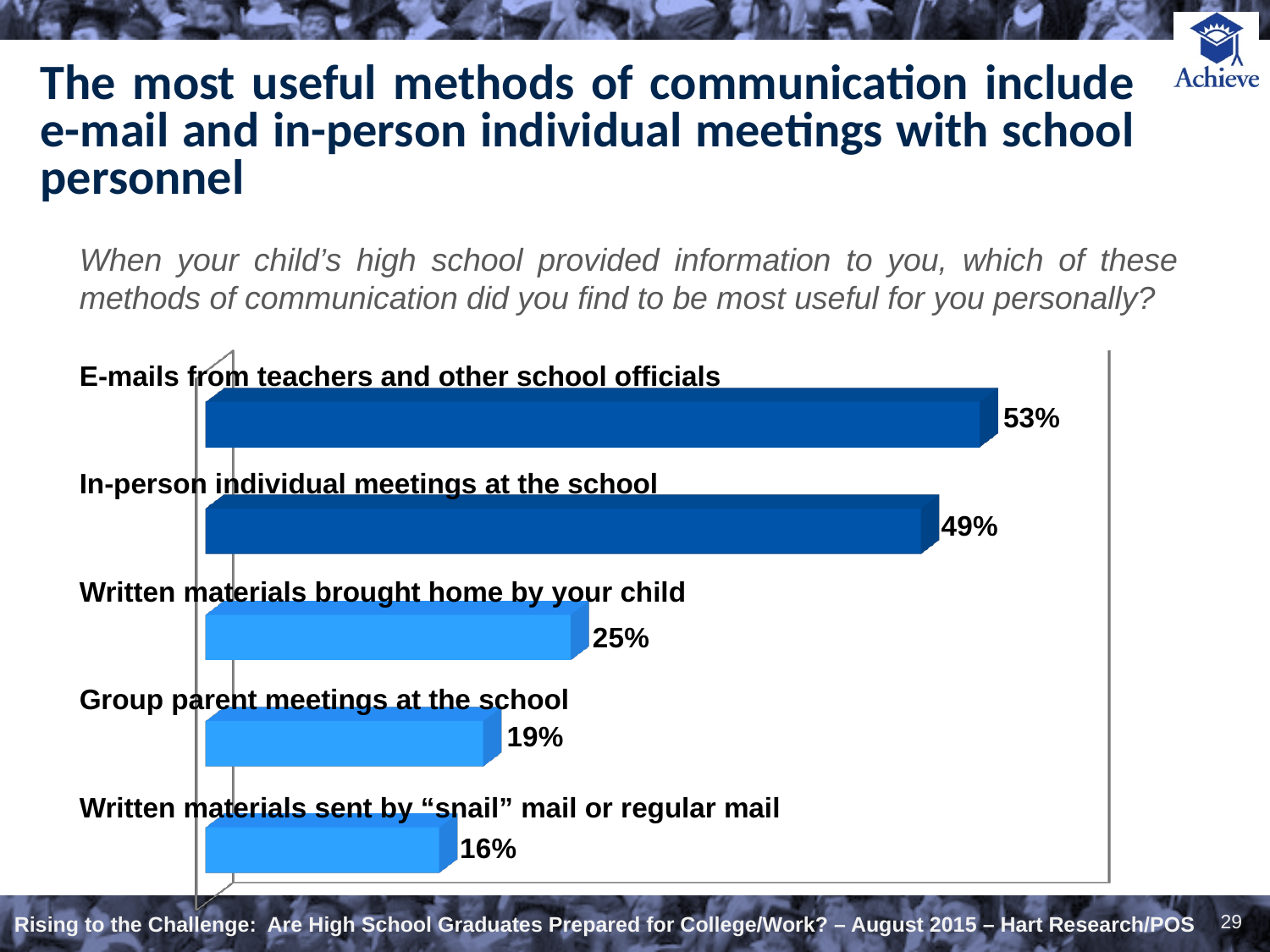
What percentage of parents found e-mails from teachers and other school officials most useful? 53% What is the difference between the values for e-mails from teachers and other school officials and in-person individual meetings at the school? 4% What is the value for written materials sent by "snail" mail or regular mail? 16% Which is larger: group parent meetings at the school or written materials sent by "snail" mail or regular mail? Group parent meetings at the school What is the difference between written materials brought home by your child and group parent meetings at the school? 6% Which method of communication has the highest value? E-mails from teachers and other school officials Do the values rise or fall going from the top bar to the bottom bar? Fall What is the value for in-person individual meetings at the school? 49% Which method of communication has the lowest value? Written materials sent by "snail" mail or regular mail What type of chart is shown on the slide? Bar chart How many methods of communication are shown in the chart? 5 What percentage is shown for written materials brought home by your child? 25%